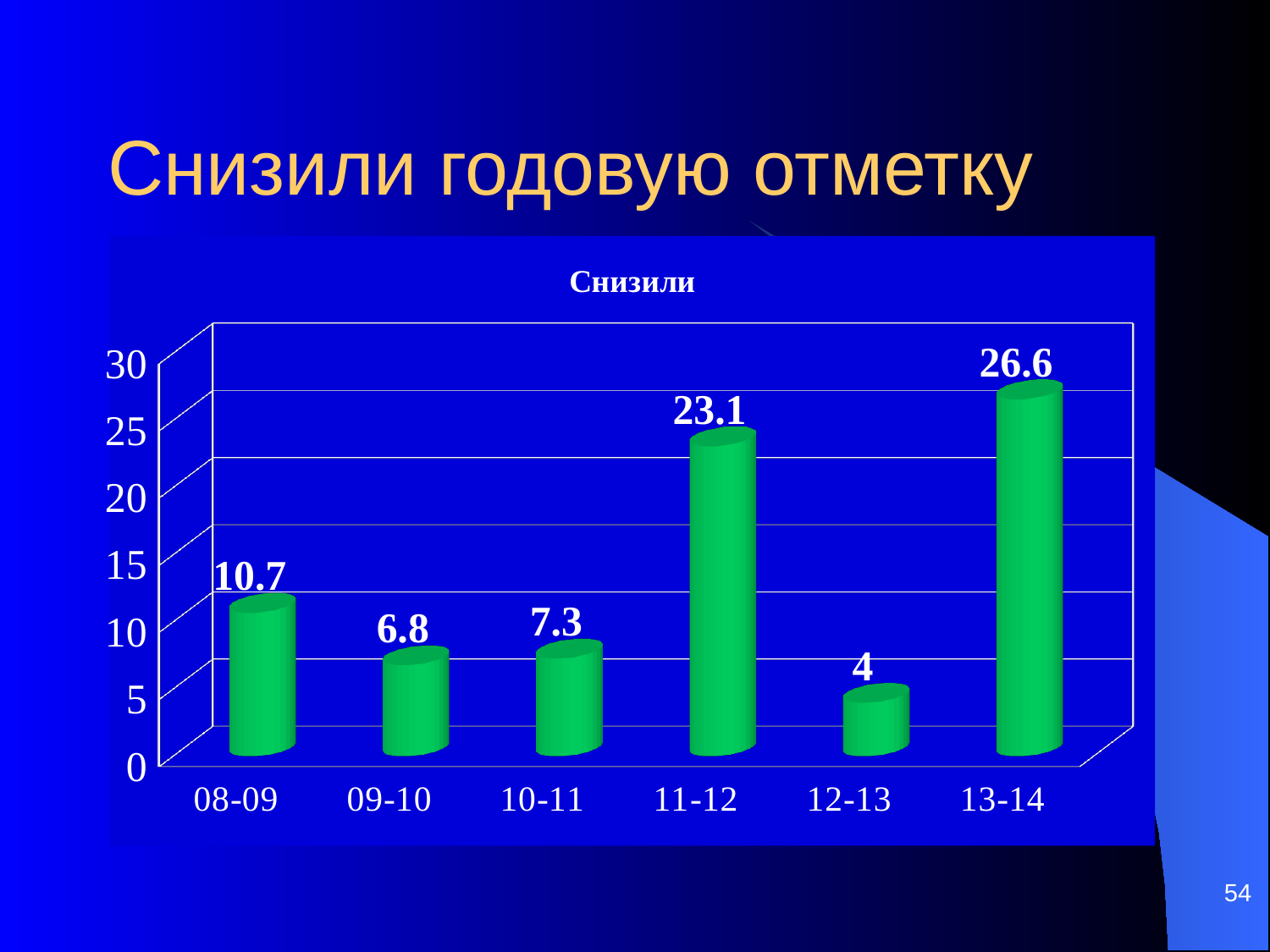
What is the value for 08-09? 10.7 Which category has the highest value? 13-14 What is the title of the chart? Снизили What is the difference between the values for 08-09 and 09-10? 3.9 What is the value for 11-12? 23.1 How many categories are shown on the x axis? 6 What is the value for 12-13? 4 Which is larger, the value for 10-11 or the value for 09-10? 10-11 Is the value for 11-12 greater or less than 20? greater Which category has the lowest value? 12-13 What is the difference between the values for 13-14 and 11-12? 3.5 What kind of chart is shown on the slide? bar chart